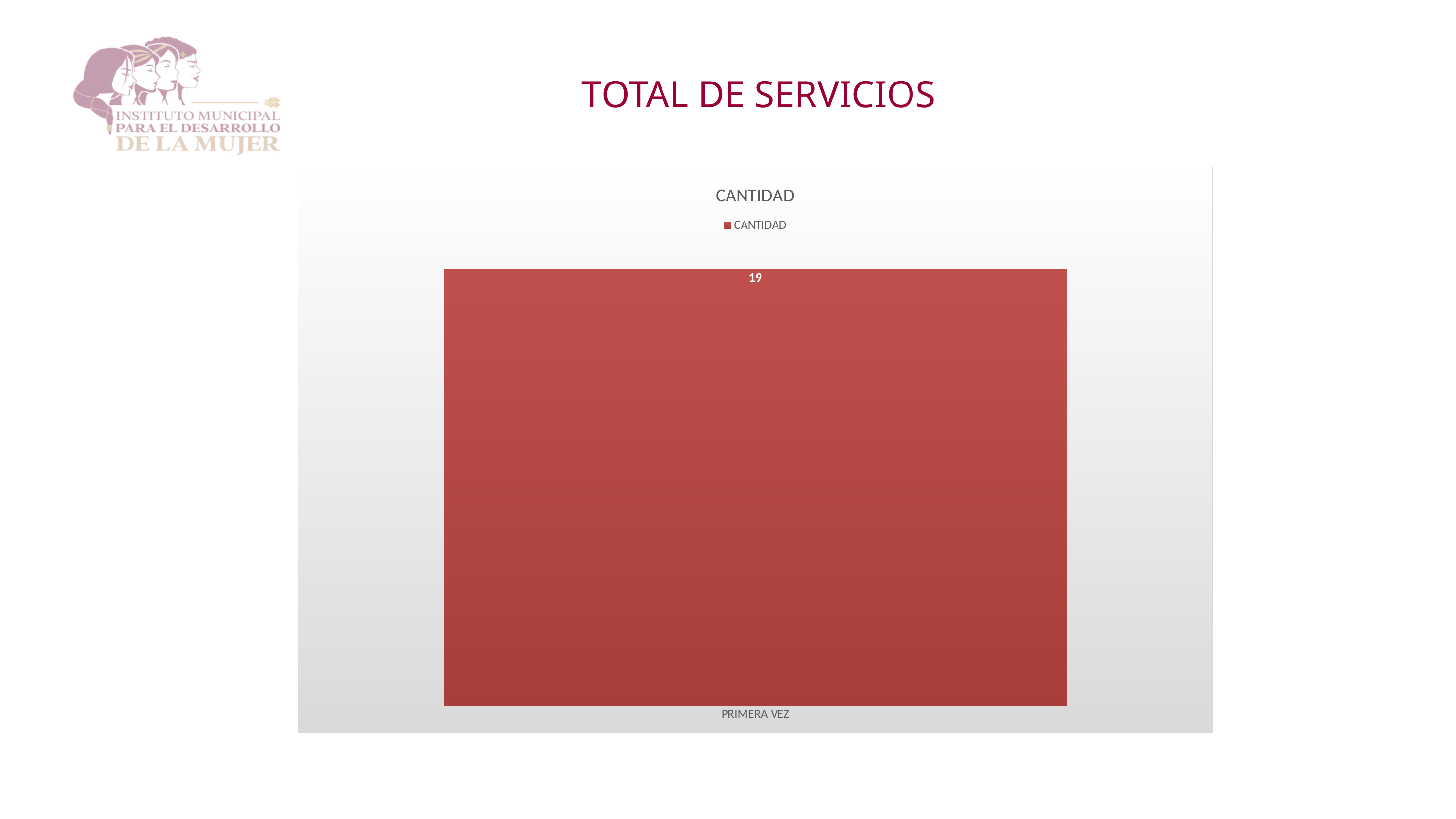
What series name is listed in the chart legend? CANTIDAD How many series does the legend list? 1 What is the value for PRIMERA VEZ? 19 What kind of chart is shown on the slide? bar chart Which category has the highest value in the chart? PRIMERA VEZ How many categories are shown on the x axis of the chart? 1 What is the title of the chart? CANTIDAD